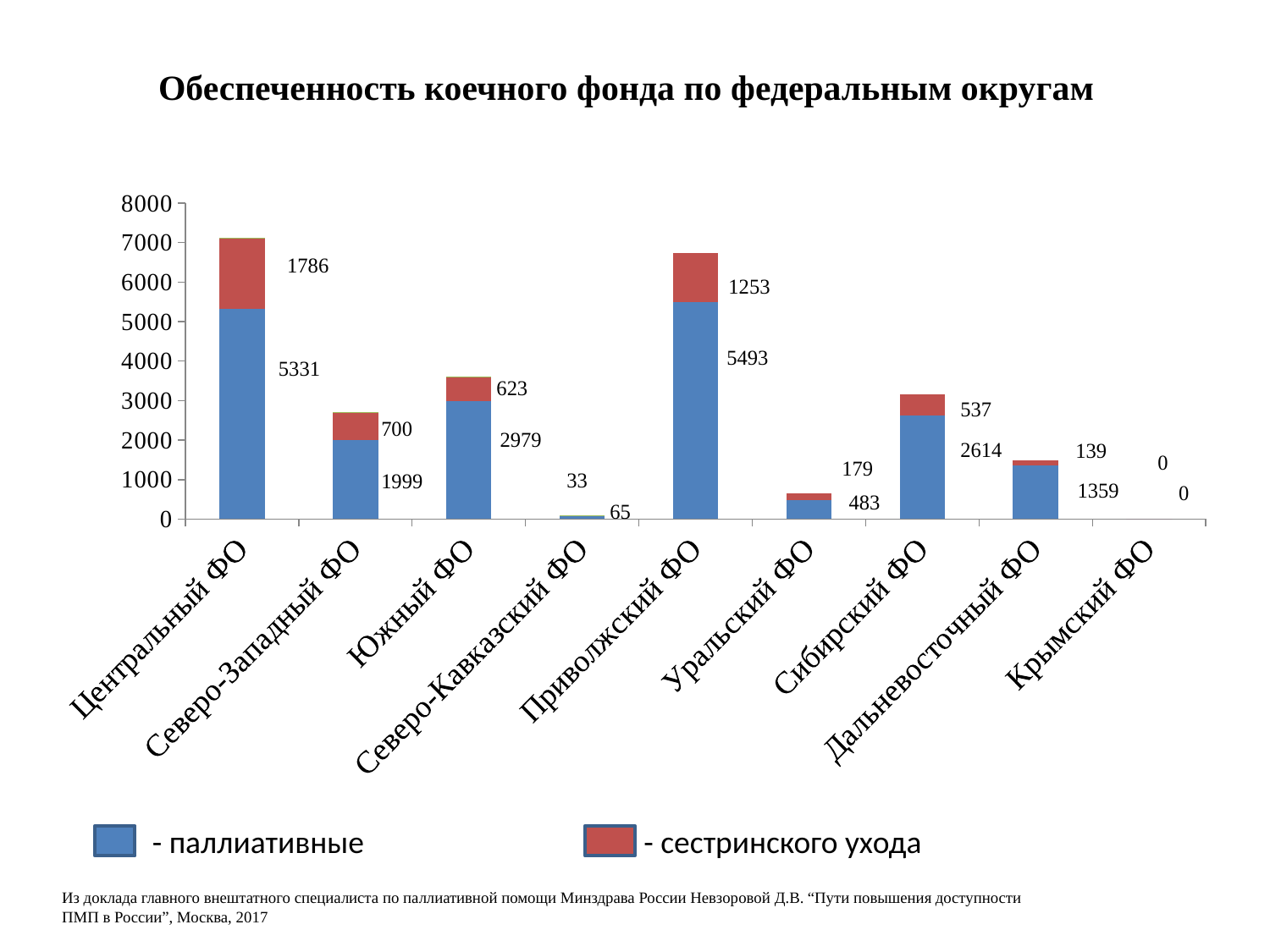
Which series is shown in red in the legend? - сестринского ухода What is the total of the stacked bar for Северо-Западный ФО? 2699 How many federal districts (categories) are shown on the x axis? 9 What is the value of палліативные beds for Приволжский ФО? 5493 What is the value of палліативные beds for Дальневосточный ФО? 1359 How many series does the legend list? 2 Which is larger: the сестринского ухода value for Южный ФО or for Сибирский ФО? Южный ФО What is the difference between the палліативные values for Центральный ФО and Приволжский ФО? 162 Which federal district has the highest value for палліативные beds? Приволжский ФО What is the value of сестринского ухода beds for Центральный ФО? 1786 Which federal district has the lowest total stacked bar? Крымский ФО What type of chart is shown on the slide? stacked bar chart